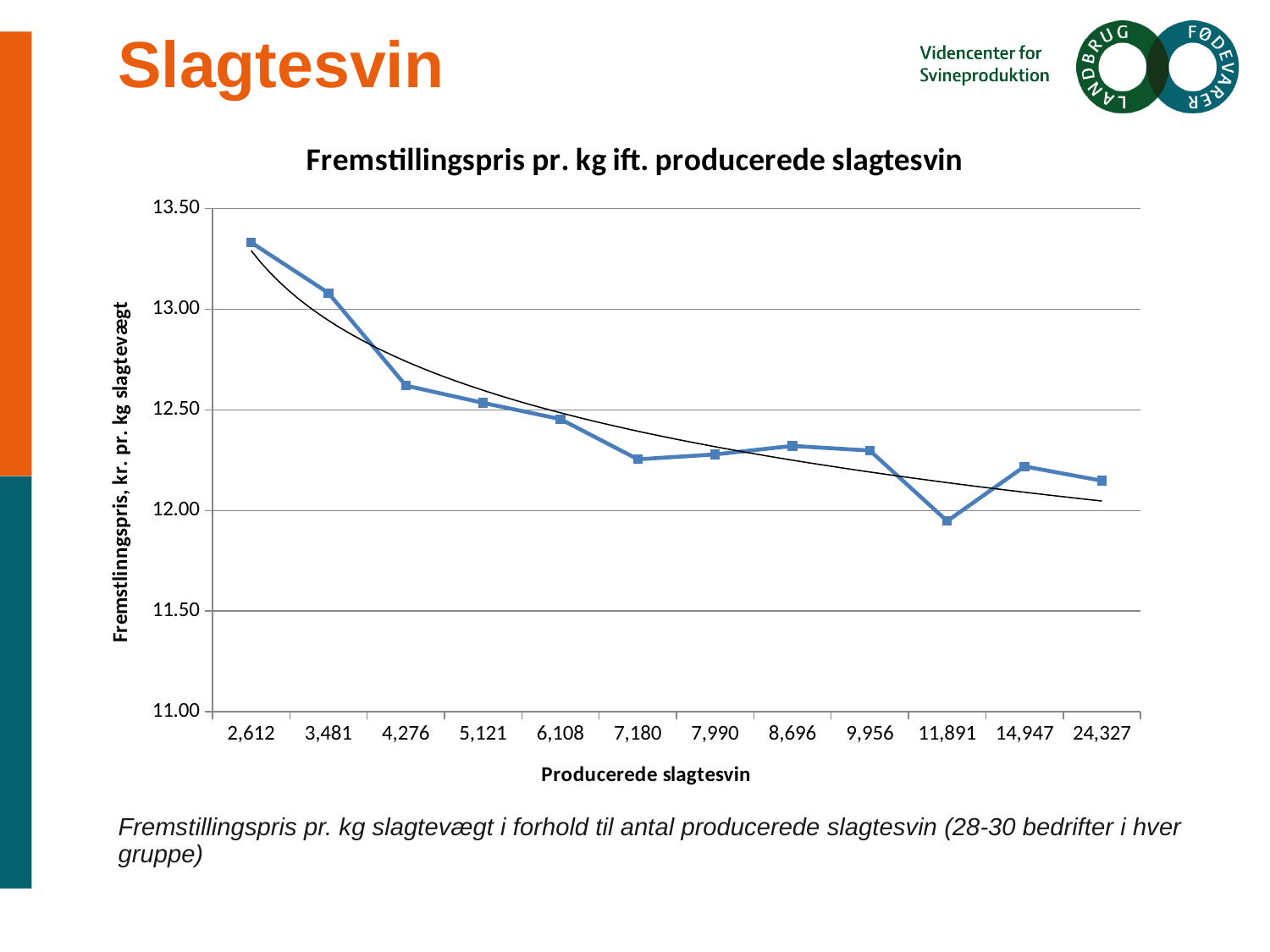
What kind of chart is shown on the slide? line chart Which category has the lowest value? 11,891 What is the label of the x axis? Producerede slagtesvin Do the values generally rise or fall as you move from left to right along the x axis? fall How many categories are shown along the x axis? 12 What is the title of the chart? Fremstillingspris pr. kg ift. producerede slagtesvin Is the value for 2,612 greater or less than 13.00? greater Is the value for 7,180 greater or less than 12.50? less Which has the larger value, 8,696 or 11,891? 8,696 Is the value for 24,327 greater or less than 12.00? greater Which has the larger value, 2,612 or 24,327? 2,612 Which category has the highest value? 2,612